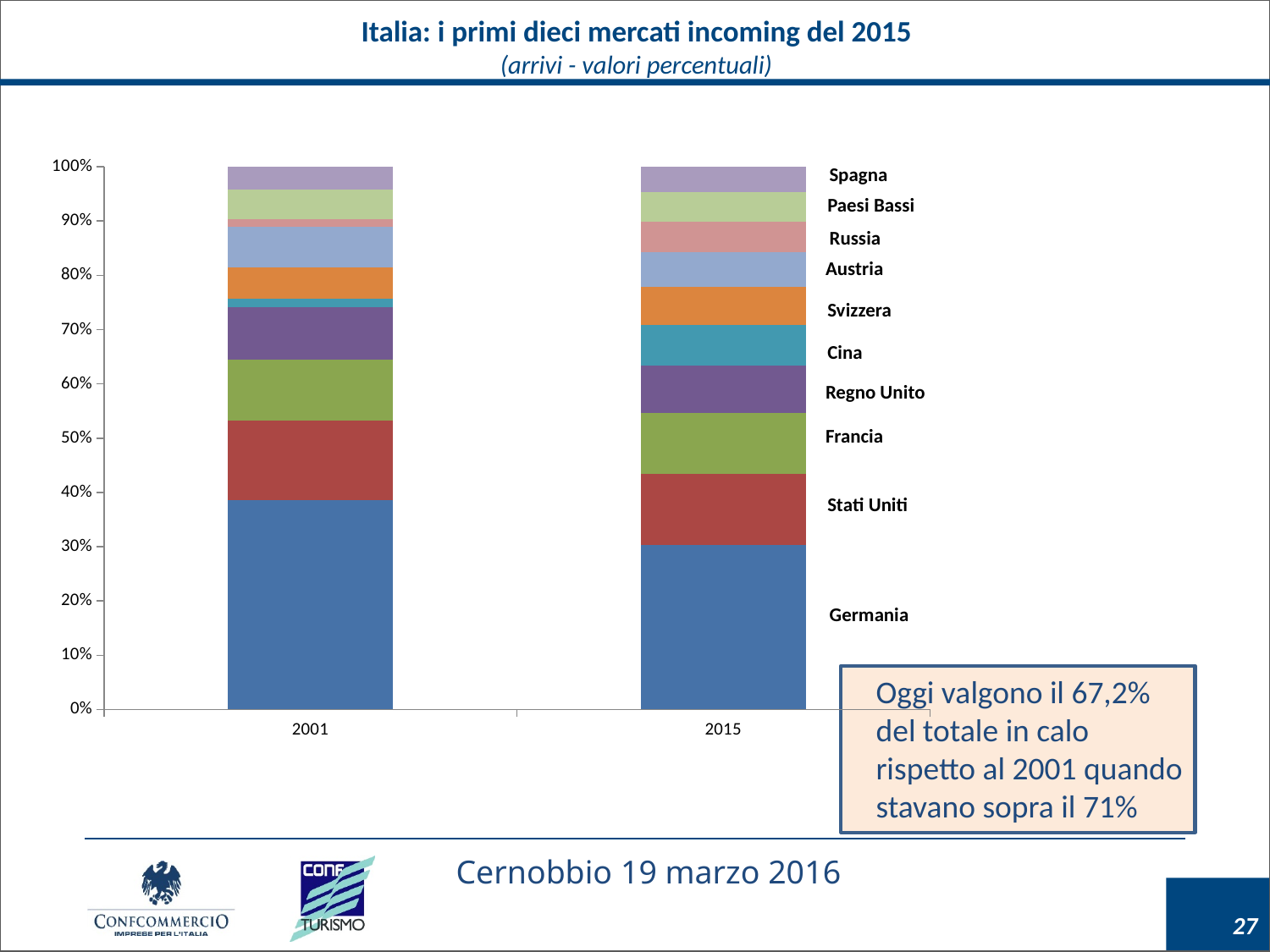
How many years (bars) are shown on the x axis? 2 Is the share for Cina larger in 2001 or in 2015? 2015 Is the share for Germania in 2015 greater or less than 40%? less Which market has the largest segment in the 2001 bar? Germania Which market is listed at the top of the series labels, corresponding to the top segment of each bar? Spagna Does the share for Germania rise or fall from 2001 to 2015? Fall Is the share for Germania in 2001 greater or less than 30%? greater Is the share for Germania larger in 2001 or in 2015? 2001 What is the title of the chart? Italia: i primi dieci mercati incoming del 2015 How many markets (series) are labelled on the chart? 10 Which market has the largest segment in the 2015 bar? Germania What kind of chart is shown on the slide? Stacked bar chart